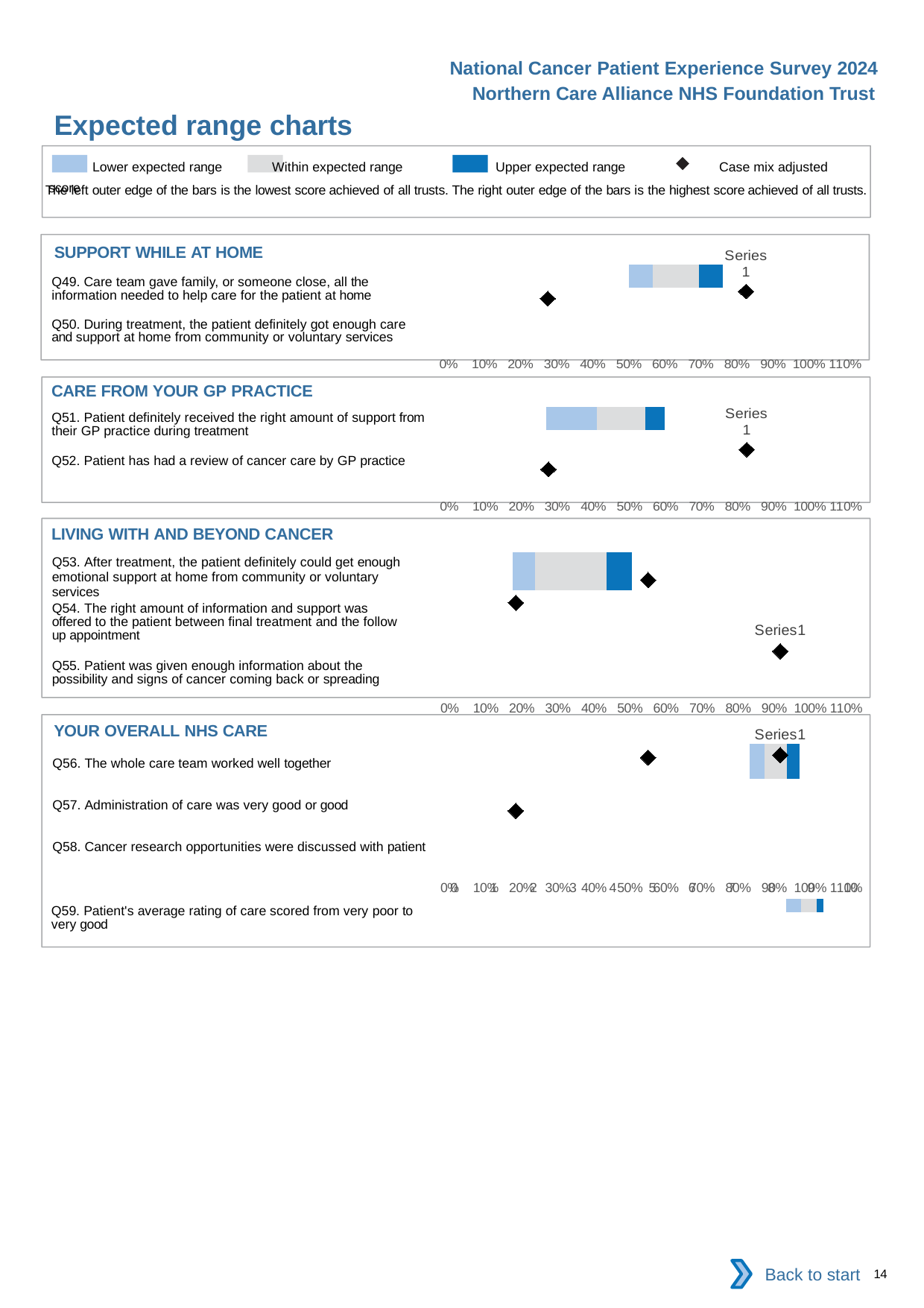
How many questions are listed in the 'YOUR OVERALL NHS CARE' chart? 4 In the 'LIVING WITH AND BEYOND CANCER' chart, is the rightmost diamond marker greater or less than 80%? greater In the 'SUPPORT WHILE AT HOME' chart, is the rightmost diamond marker greater or less than 70%? greater How many questions are listed in the 'LIVING WITH AND BEYOND CANCER' chart? 3 What kind of chart is used in the 'SUPPORT WHILE AT HOME' section? bar chart In the 'SUPPORT WHILE AT HOME' chart, is the leftmost diamond marker greater or less than 40%? less Which legend entry is shown with a diamond marker? Case mix adjusted score How many entries does the legend at the top of the slide list? 4 What is the highest tick label shown on the x axis of the 'CARE FROM YOUR GP PRACTICE' chart? 110% What is the title of the slide's charts? Expected range charts How many questions are listed in the 'SUPPORT WHILE AT HOME' chart? 2